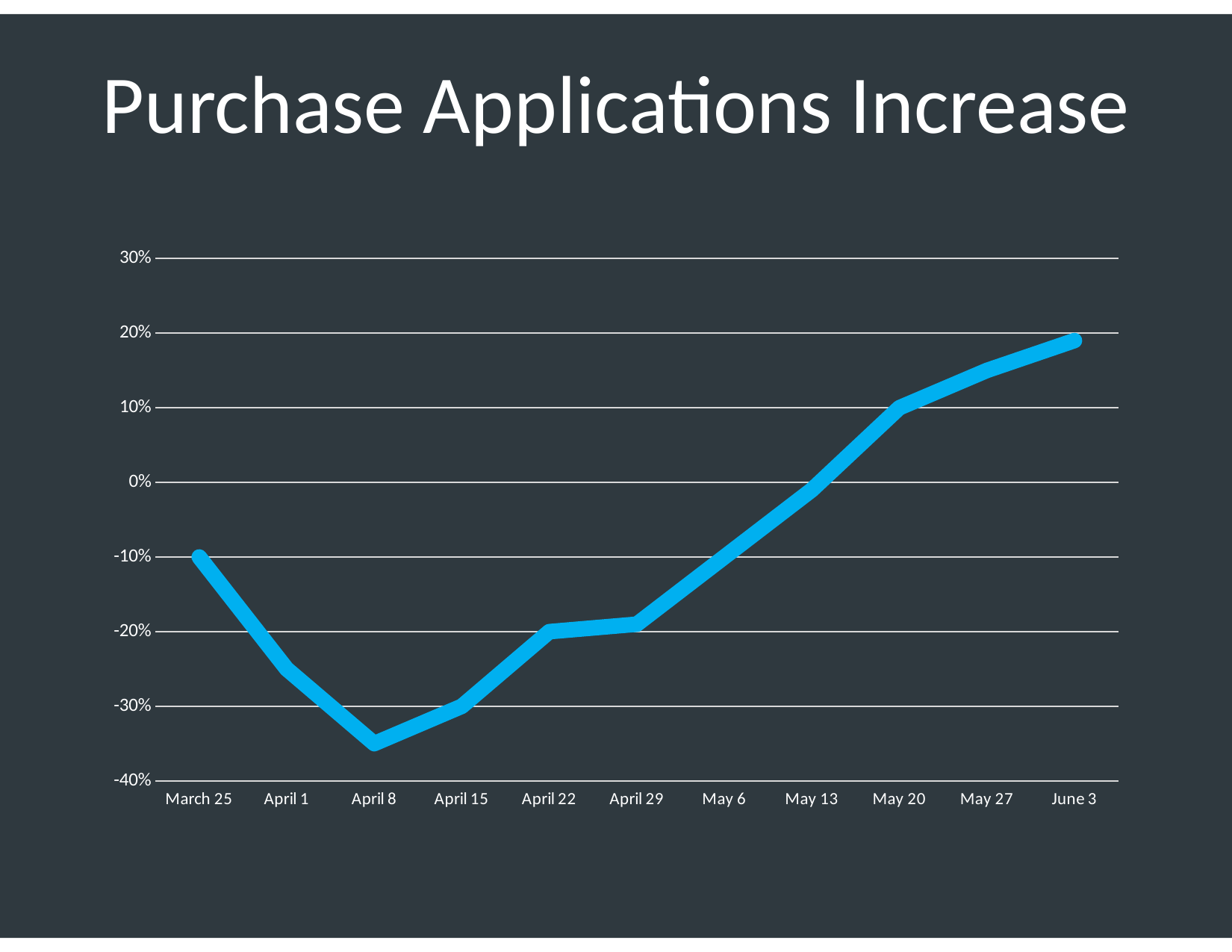
Which is larger, the value for June 3 or the value for March 25? June 3 What kind of chart is shown on the slide? line chart How many dates are plotted along the x axis? 11 On which date is the value lowest? April 8 Is the value for April 8 greater or less than -30%? less Is the value for May 27 greater or less than 10%? greater Is the value for April 1 greater or less than -20%? less What is the title of the chart? Purchase Applications Increase On which date is the value highest? June 3 Does the line rise or fall between April 8 and June 3? rise